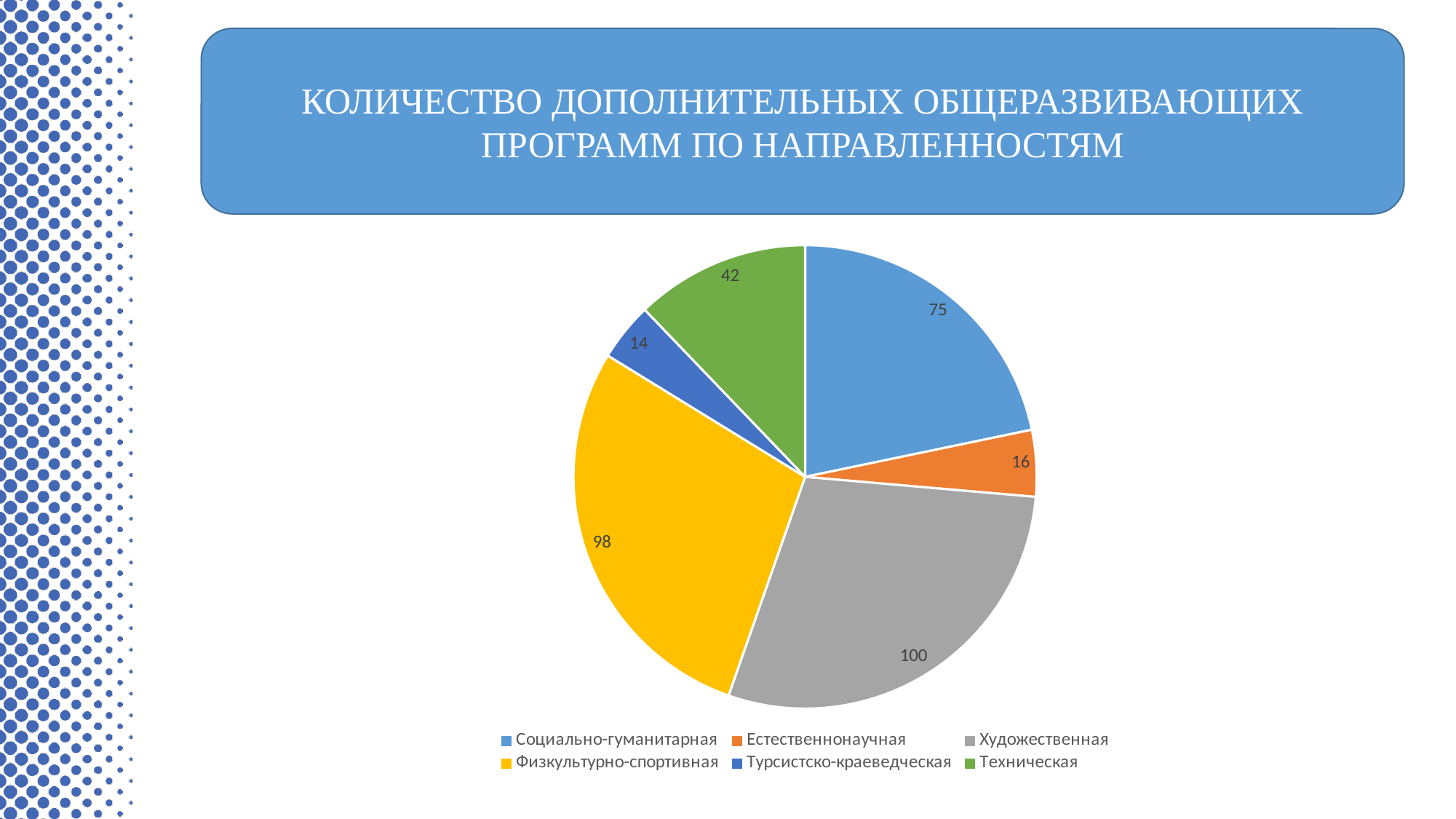
How many slices does the pie chart have? 6 What is the difference between the values for Физкультурно-спортивная and Естественнонаучная? 82 What is the total of all the values shown in the pie chart? 345 What is the value for Социально-гуманитарная? 75 Which is larger, the value for Техническая or the value for Естественнонаучная? Техническая What is the value for Художественная? 100 What is the value for Турсистско-краеведческая? 14 Which category has the largest value? Художественная Which category has the smallest value? Турсистско-краеведческая Which colour represents Физкультурно-спортивная in the pie chart? Yellow What type of chart is shown on the slide? Pie chart What is the value for Техническая? 42